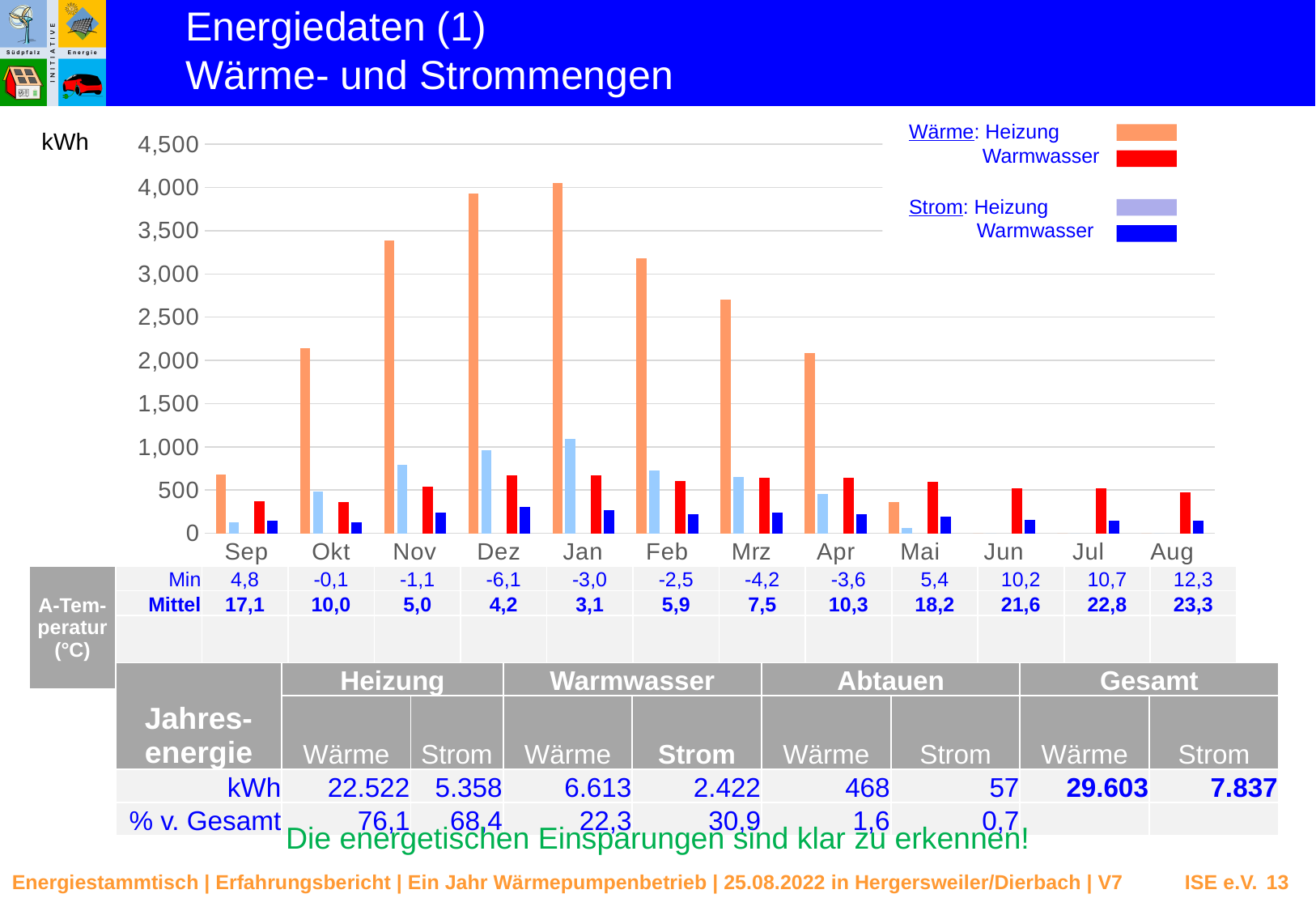
What unit is shown for the y axis of the chart? kWh How many months are shown along the x axis of the chart? 12 Is the Wärme: Heizung value for Apr greater or less than 2,500? less Which is larger in Jan, the Wärme: Warmwasser bar or the Strom: Warmwasser bar? Wärme: Warmwasser Do the Wärme: Heizung values rise or fall from Jan to Mai? fall What kind of chart is shown on the slide? bar chart Which is larger, the Wärme: Heizung bar for Nov or for Mrz? Nov Which month has the highest Strom: Heizung bar? Jan Is the Wärme: Heizung value for Dez greater or less than 3,500? greater Is the Wärme: Heizung value for Mai greater or less than 500? less How many series does the chart legend list? 4